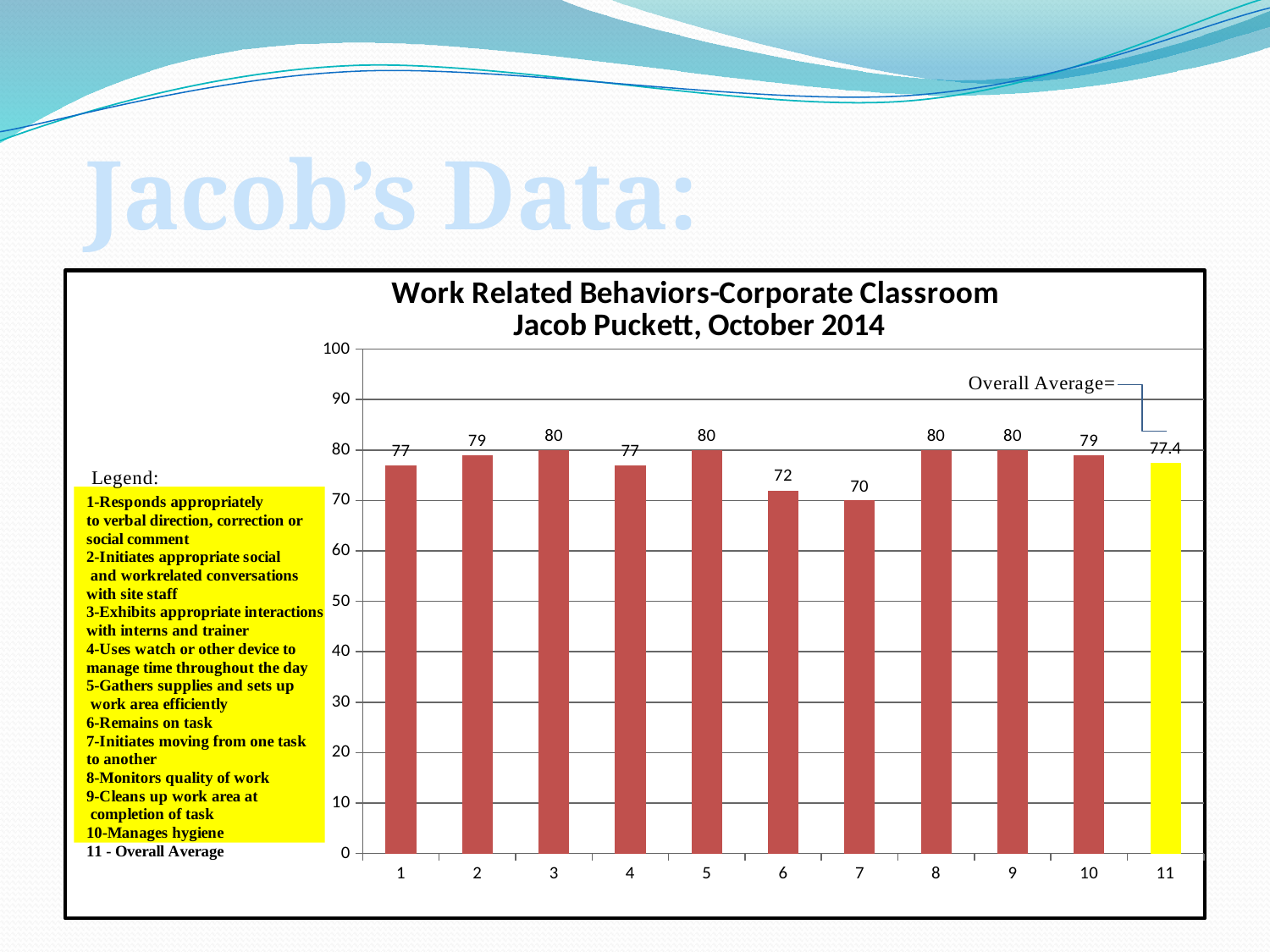
What is the difference between the values for category 3 and category 7? 10 Which category has the lowest value in the chart? 7 Which is larger, the value for category 2 or the value for category 6? Category 2 What colour is the bar for category 11 (Overall Average)? Yellow What is the difference between the values for category 1 and category 2? 2 What is the value shown for category 11, the Overall Average? 77.4 What is the value for category 6 in the chart? 72 What kind of chart is shown on the slide? Bar chart Is the value for category 7 greater or less than 80? less How many categories are plotted on the x axis of the chart? 11 What is the value for category 7 in the chart? 70 What is the title of the chart? Work Related Behaviors-Corporate Classroom Jacob Puckett, October 2014